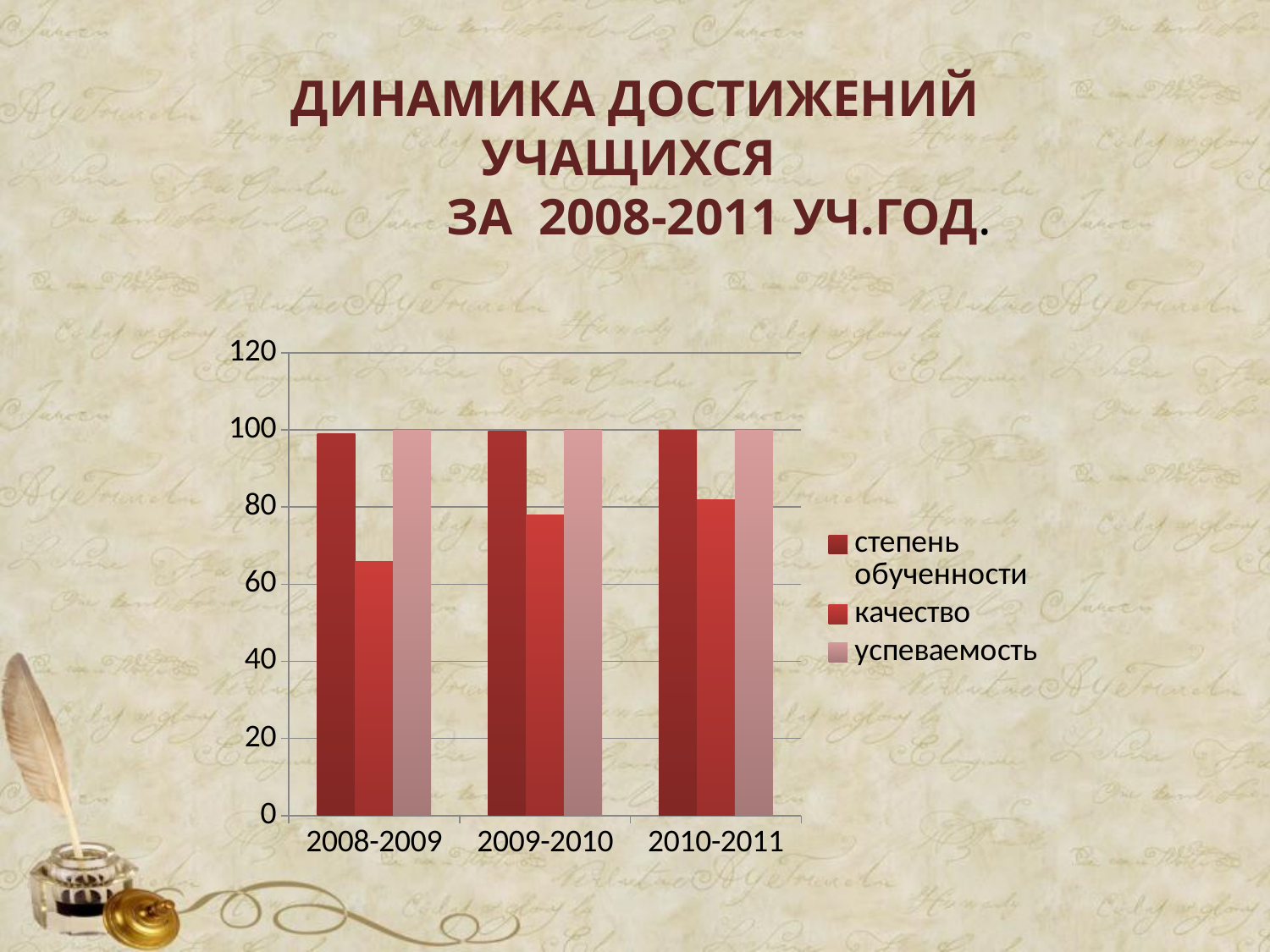
Does the value of качество rise or fall from 2008-2009 to 2010-2011? rise Is the value of качество for 2010-2011 greater or less than 80? greater What period does the chart title say the data covers? 2008-2011 уч.год How many series does the legend list? 3 What is the value of успеваемость for 2010-2011? 100 How many academic-year categories are shown on the x axis? 3 Is the value of качество for 2008-2009 greater or less than 80? less What kind of chart is shown on the slide? bar chart In which year is качество the lowest? 2008-2009 Which series is shown in the lightest (pink) colour in the legend? успеваемость In which year is качество the highest? 2010-2011 Which is larger in 2009-2010: степень обученности or качество? степень обученности